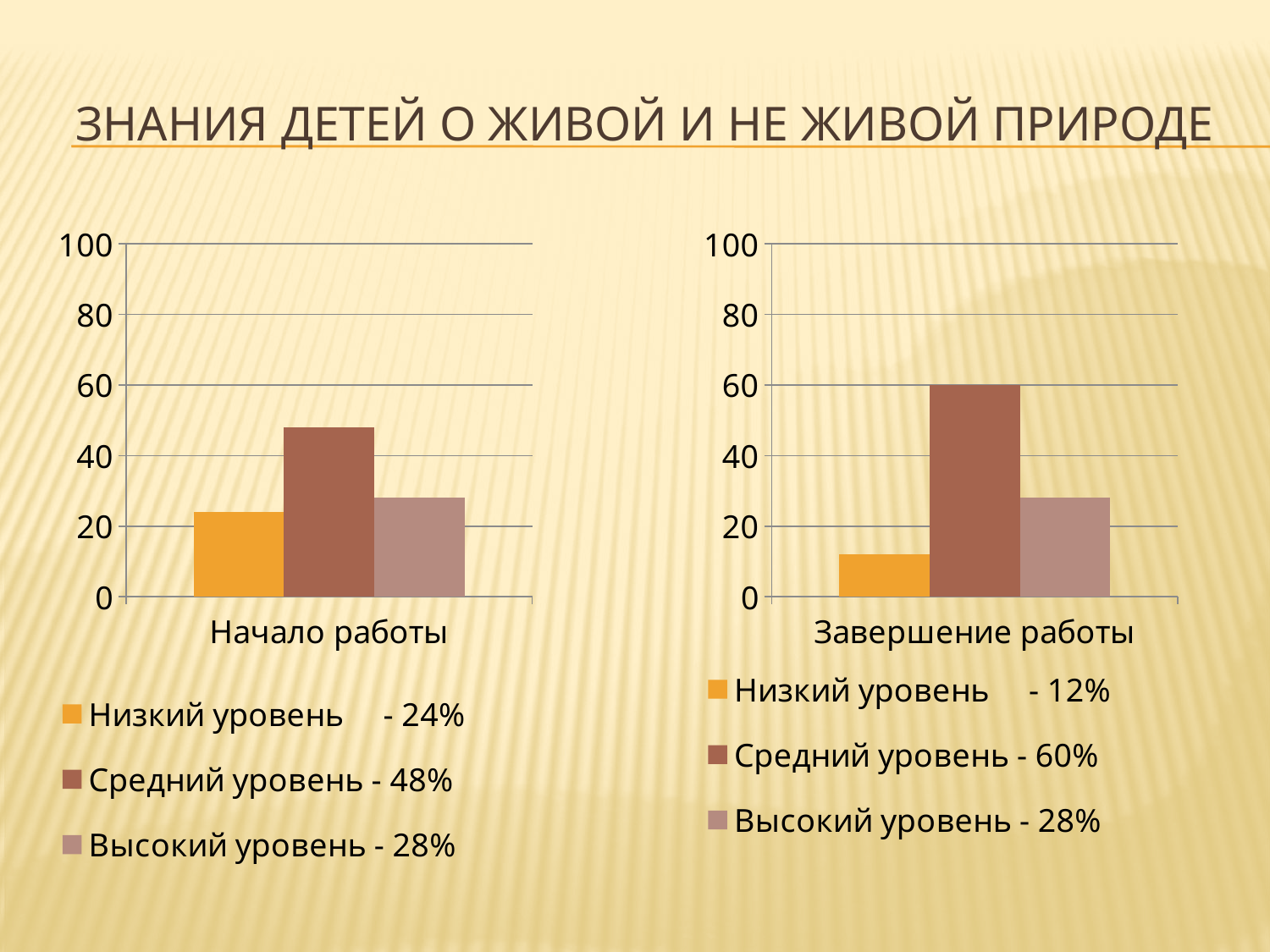
In the right chart (Завершение работы), what is the value for Низкий уровень? 12% What kind of chart is the right chart (Завершение работы)? bar chart In the left chart (Начало работы), what is the value for Средний уровень? 48% In the left chart (Начало работы), which series has the highest value? Средний уровень In the right chart (Завершение работы), what is the value for Высокий уровень? 28% In the right chart (Завершение работы), what is the difference between Средний уровень and Высокий уровень? 32% How many series does the legend of the left chart (Начало работы) list? 3 What is the title of the slide containing the two charts? Знания детей о живой и не живой природе In the right chart (Завершение работы), is the value for Средний уровень greater or less than 40? greater In the left chart (Начало работы), what is the difference between Средний уровень and Низкий уровень? 24% In the left chart (Начало работы), which is larger: Высокий уровень or Низкий уровень? Высокий уровень In the right chart (Завершение работы), which series has the lowest value? Низкий уровень